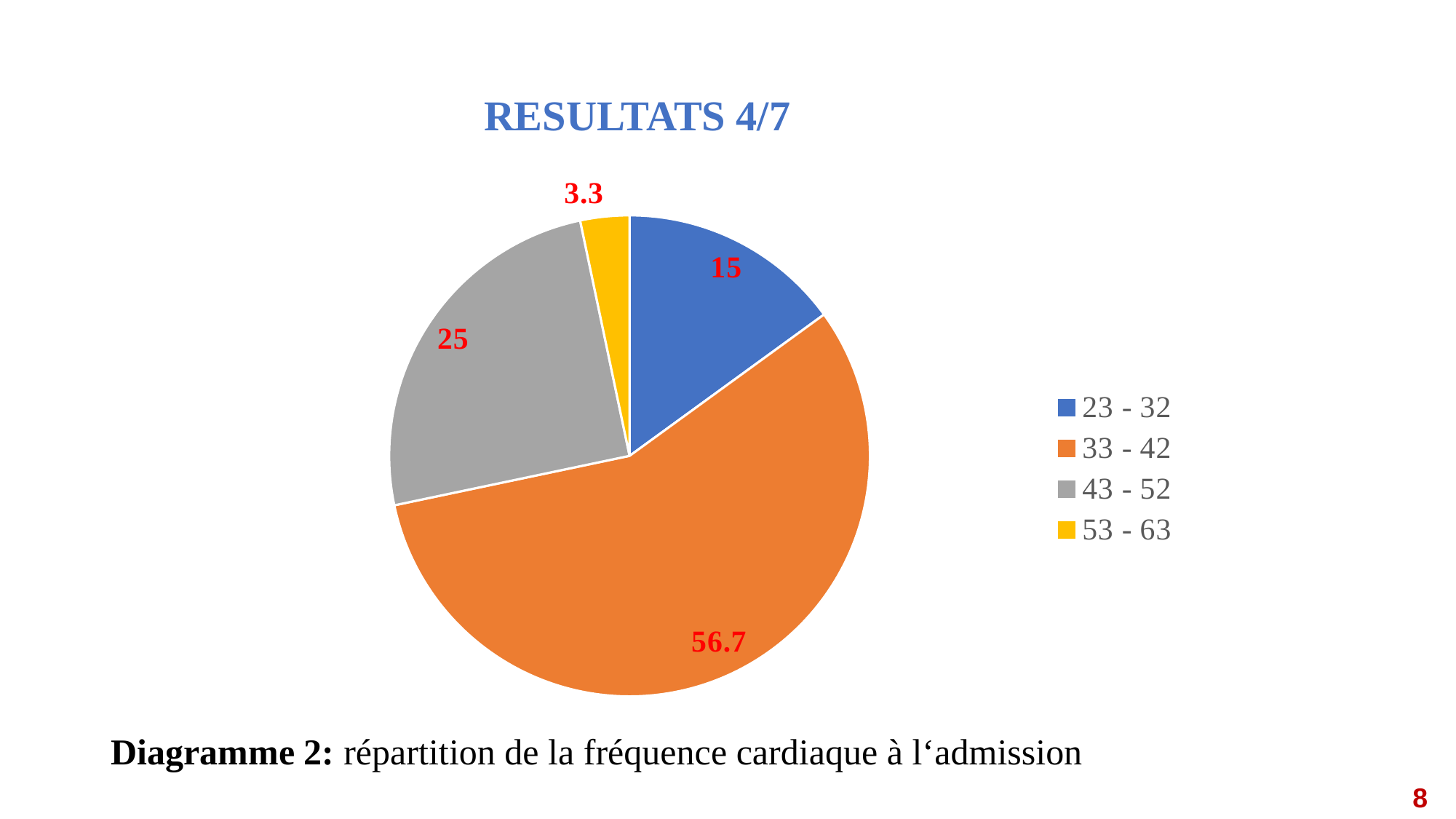
What is the caption below the chart? Diagramme 2: répartition de la fréquence cardiaque à l'admission What is the value shown for the 53 - 63 slice? 3.3 What is the value shown for the 33 - 42 slice? 56.7 Which is larger, the value for 43 - 52 or the value for 23 - 32? 43 - 52 How many categories does the pie chart have? 4 What is the difference between the values for 43 - 52 and 23 - 32? 10 What is the value shown for the 43 - 52 slice? 25 What kind of chart is shown on the slide? pie chart What is the value shown for the 23 - 32 slice? 15 Which category has the largest slice? 33 - 42 What colour is the 43 - 52 slice? grey Which category has the smallest slice? 53 - 63